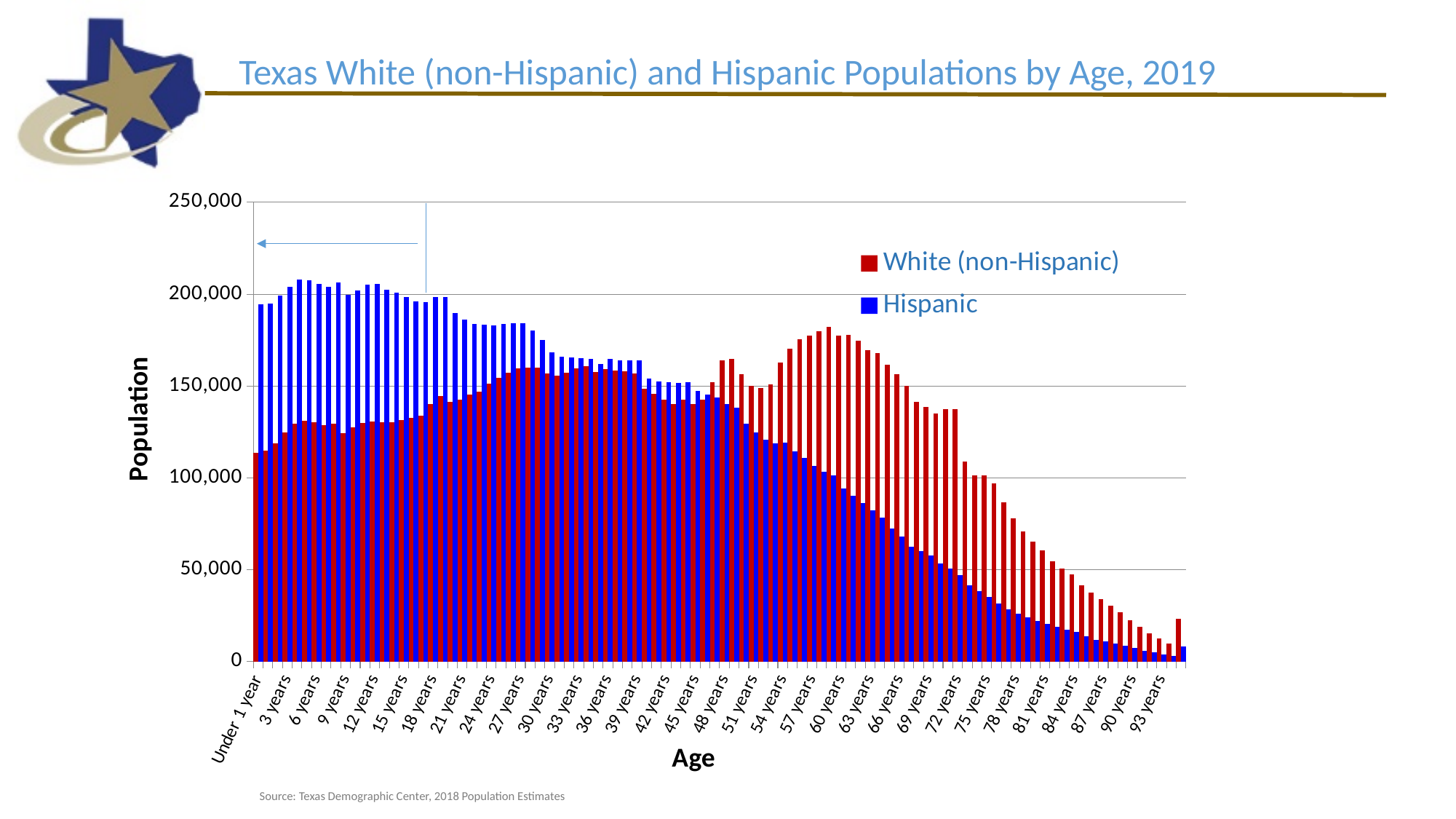
How many series does the legend list? 2 At Under 1 year, which series has the larger value, White (non-Hispanic) or Hispanic? Hispanic At 60 years, which series has the larger value, White (non-Hispanic) or Hispanic? White (non-Hispanic) Do the Hispanic values generally rise or fall from 30 years to 93 years? fall What colour represents the Hispanic series in the legend? blue Is the Hispanic value for 75 years greater or less than 50,000? less Is the White (non-Hispanic) value for 93 years greater or less than 50,000? less Is the White (non-Hispanic) value for Under 1 year greater or less than 150,000? less What kind of chart is shown on the slide? bar chart